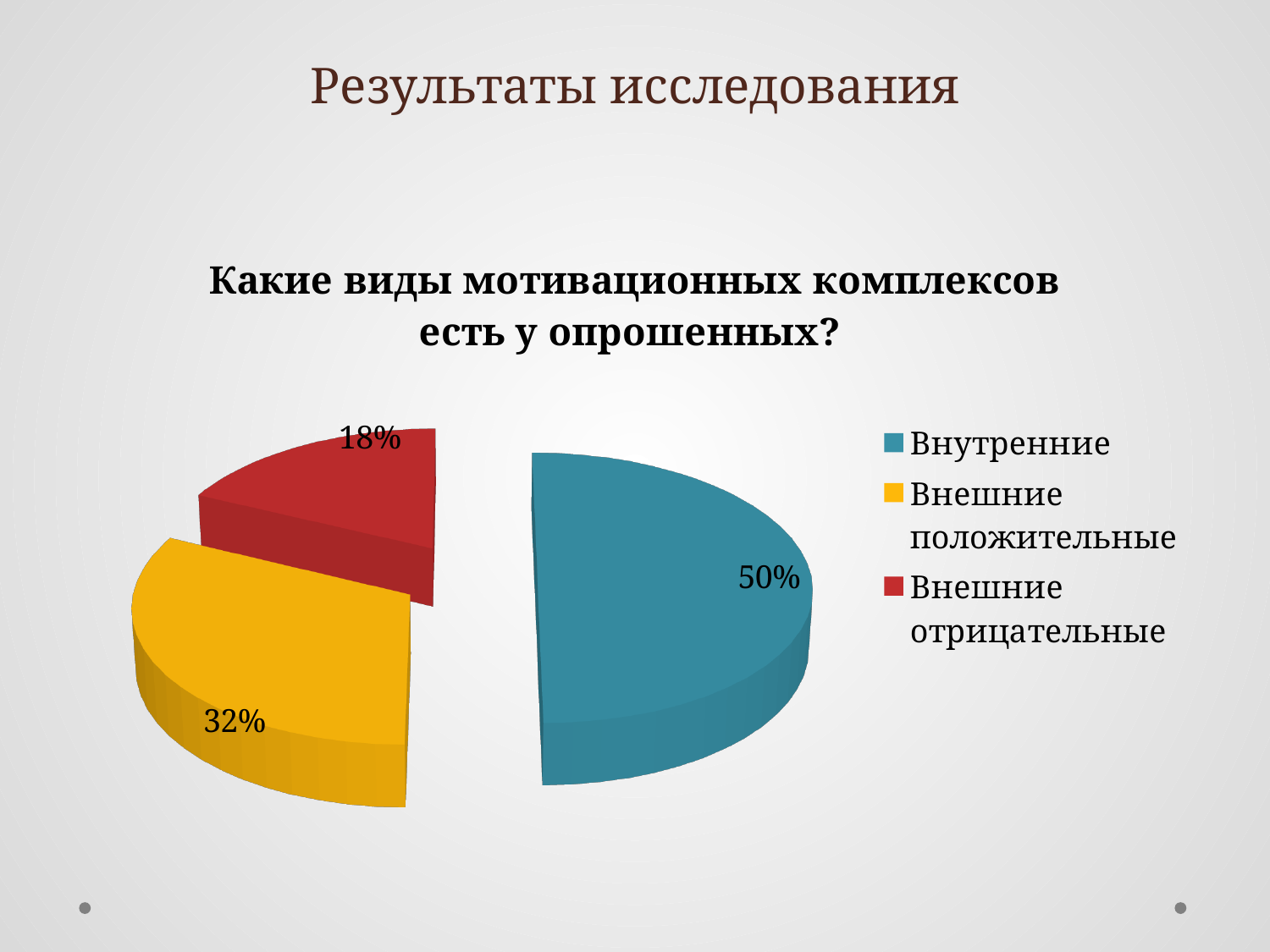
Which category has the largest slice? Внутренние Which is larger, Внешние положительные or Внешние отрицательные? Внешние положительные What kind of chart is shown on the slide? Pie chart What is the value for Внешние отрицательные? 18% How many categories does the pie chart show? 3 What is the value for Внешние положительные? 32% What colour is the slice for Внешние положительные? Yellow What is the title of the chart? Какие виды мотивационных комплексов есть у опрошенных? What is the difference between the values for Внешние положительные and Внешние отрицательные? 14% What share of the pie does Внутренние have? 50% Which category has the smallest slice? Внешние отрицательные What is the difference between the values for Внутренние and Внешние положительные? 18%